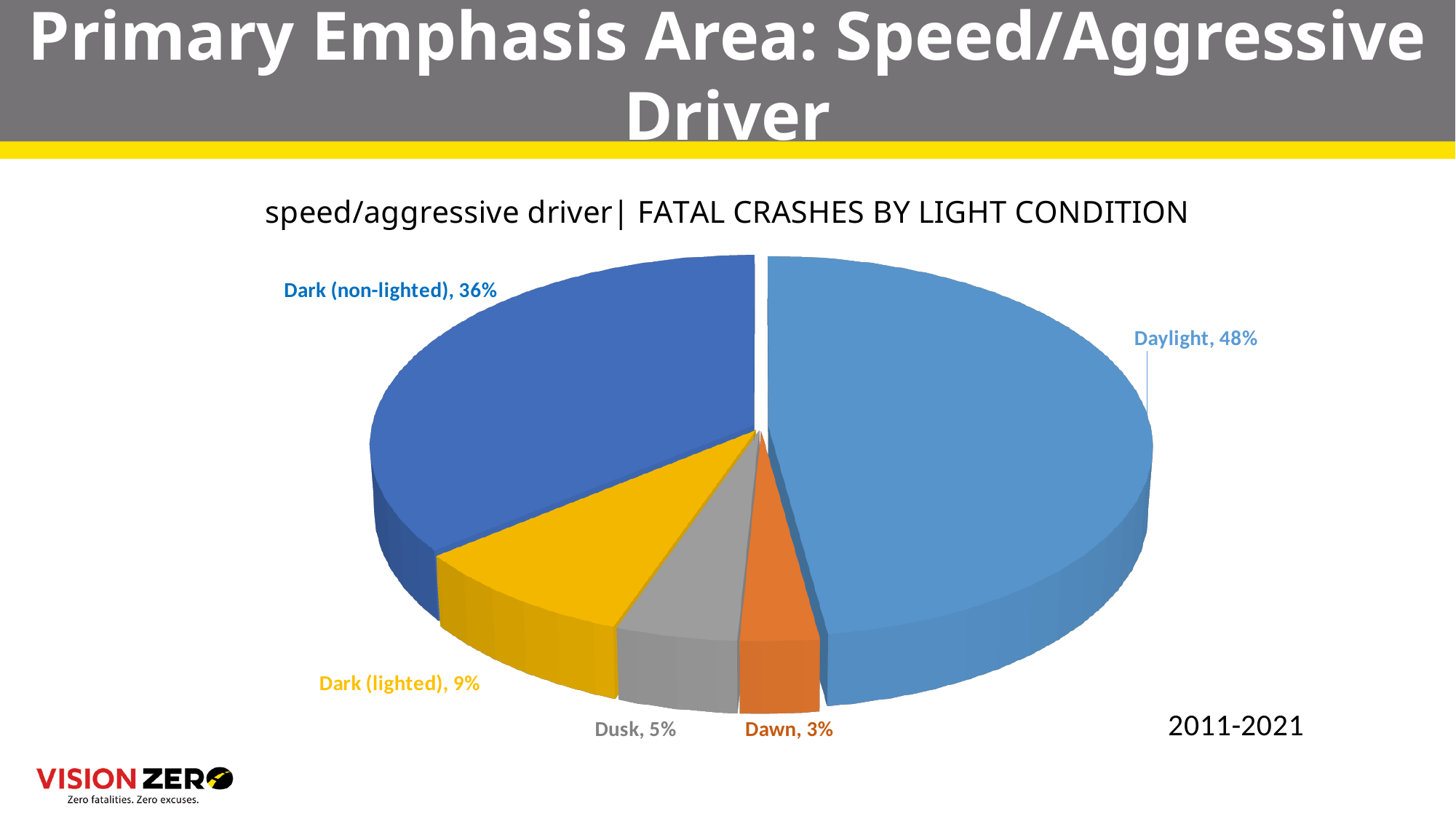
Which light condition has the smallest share of fatal crashes? Dawn What time period does the chart cover? 2011-2021 What share of fatal crashes occurred in Dark (lighted) conditions? 9% What share of fatal crashes occurred in Dark (non-lighted) conditions? 36% What share of fatal crashes occurred at Dusk? 5% Which has a larger share of fatal crashes, Dusk or Dark (lighted)? Dark (lighted) Which light condition has the largest share of fatal crashes? Daylight What share of fatal crashes occurred at Dawn? 3% What is the difference in percentage points between the Daylight and Dark (non-lighted) shares? 12 How many light condition categories are shown in the pie chart? 5 What type of chart is shown on the slide? Pie chart What share of fatal crashes occurred in Daylight? 48%